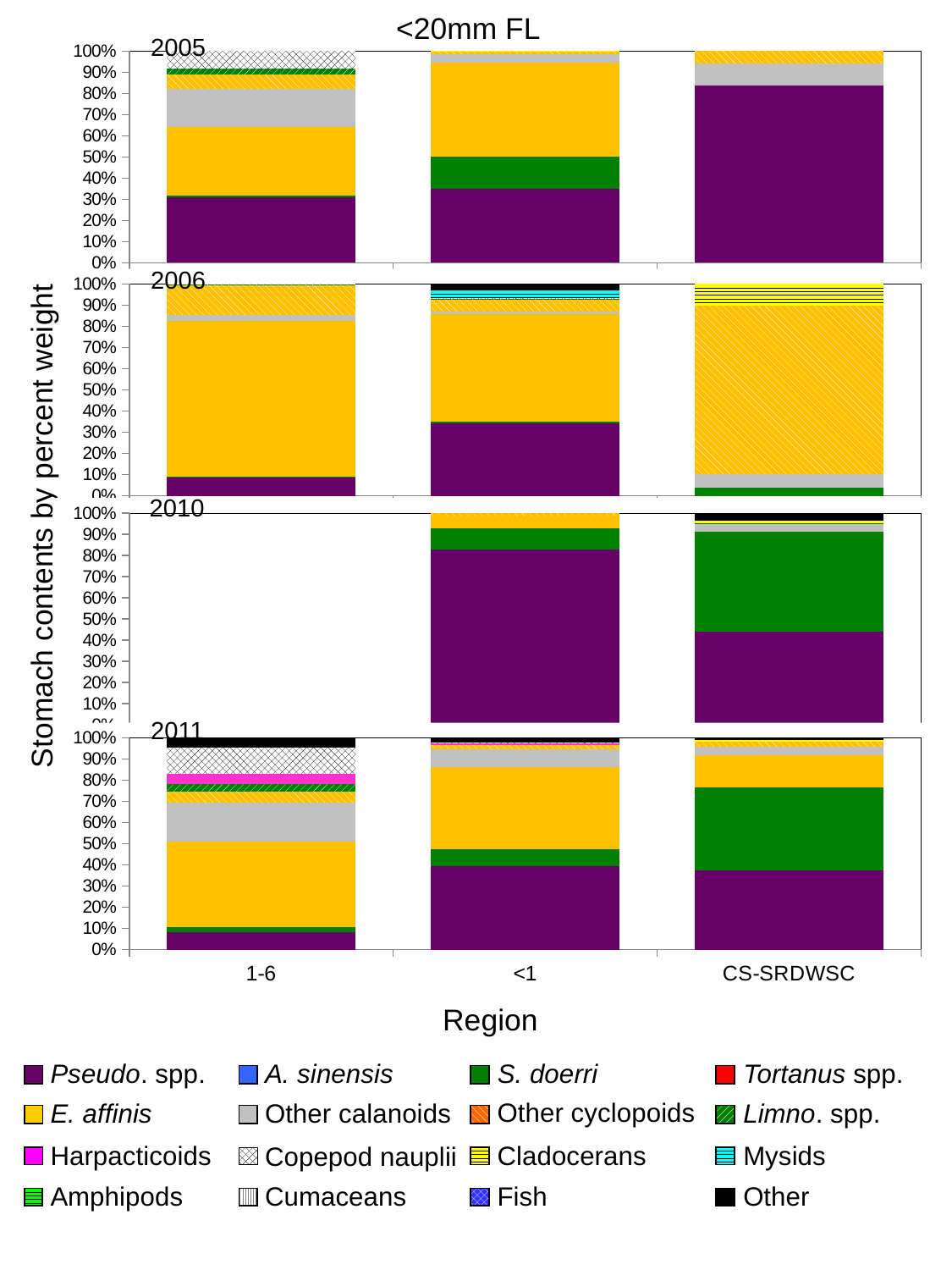
In the 2005 panel, is the Pseudo. spp. share for CS-SRDWSC greater or less than 80%? greater What kind of chart is used on this slide for each year panel? Stacked bar chart How many regions are shown on the x axis? 3 What is the title shown above the charts? <20mm FL In the 2006 panel, is the Pseudo. spp. share for region <1 greater or less than 30%? greater In the 2005 panel, is the Pseudo. spp. share for region 1-6 greater or less than 40%? less How many entries does the legend list? 16 In the 2010 panel, how many bars are plotted? 2 In the 2005 panel, which region has the largest Pseudo. spp. share? CS-SRDWSC In the 2010 panel, which region has the larger Pseudo. spp. share, <1 or CS-SRDWSC? <1